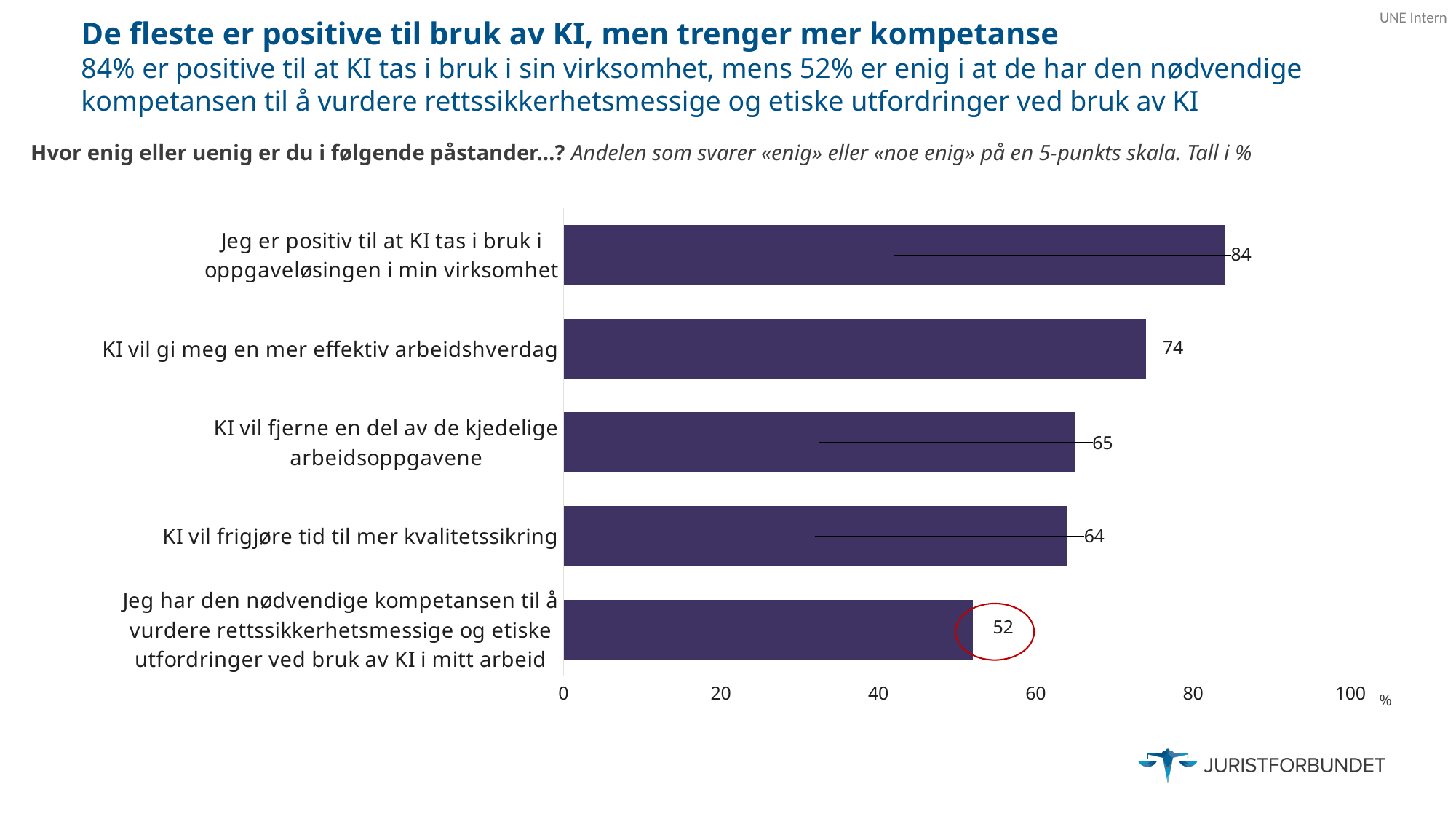
What value is shown for "KI vil gi meg en mer effektiv arbeidshverdag"? 74 What is the difference between the values for "Jeg er positiv til at KI tas i bruk i oppgaveløsingen i min virksomhet" and "Jeg har den nødvendige kompetansen til å vurdere rettssikkerhetsmessige og etiske utfordringer ved bruk av KI i mitt arbeid"? 32 Which data label on the chart is circled in red? 52 What value is shown for "Jeg er positiv til at KI tas i bruk i oppgaveløsingen i min virksomhet"? 84 Is the value for "KI vil fjerne en del av de kjedelige arbeidsoppgavene" greater or less than 60? greater What value is shown for "KI vil frigjøre tid til mer kvalitetssikring"? 64 How many statements (bars) are shown in the chart? 5 Which statement has the lowest value? Jeg har den nødvendige kompetansen til å vurdere rettssikkerhetsmessige og etiske utfordringer ved bruk av KI i mitt arbeid What kind of chart is shown on the slide? Bar chart What is the difference between the values for "KI vil gi meg en mer effektiv arbeidshverdag" and "KI vil fjerne en del av de kjedelige arbeidsoppgavene"? 9 Which is larger: the value for "KI vil gi meg en mer effektiv arbeidshverdag" or for "KI vil frigjøre tid til mer kvalitetssikring"? KI vil gi meg en mer effektiv arbeidshverdag Which statement has the highest value? Jeg er positiv til at KI tas i bruk i oppgaveløsingen i min virksomhet